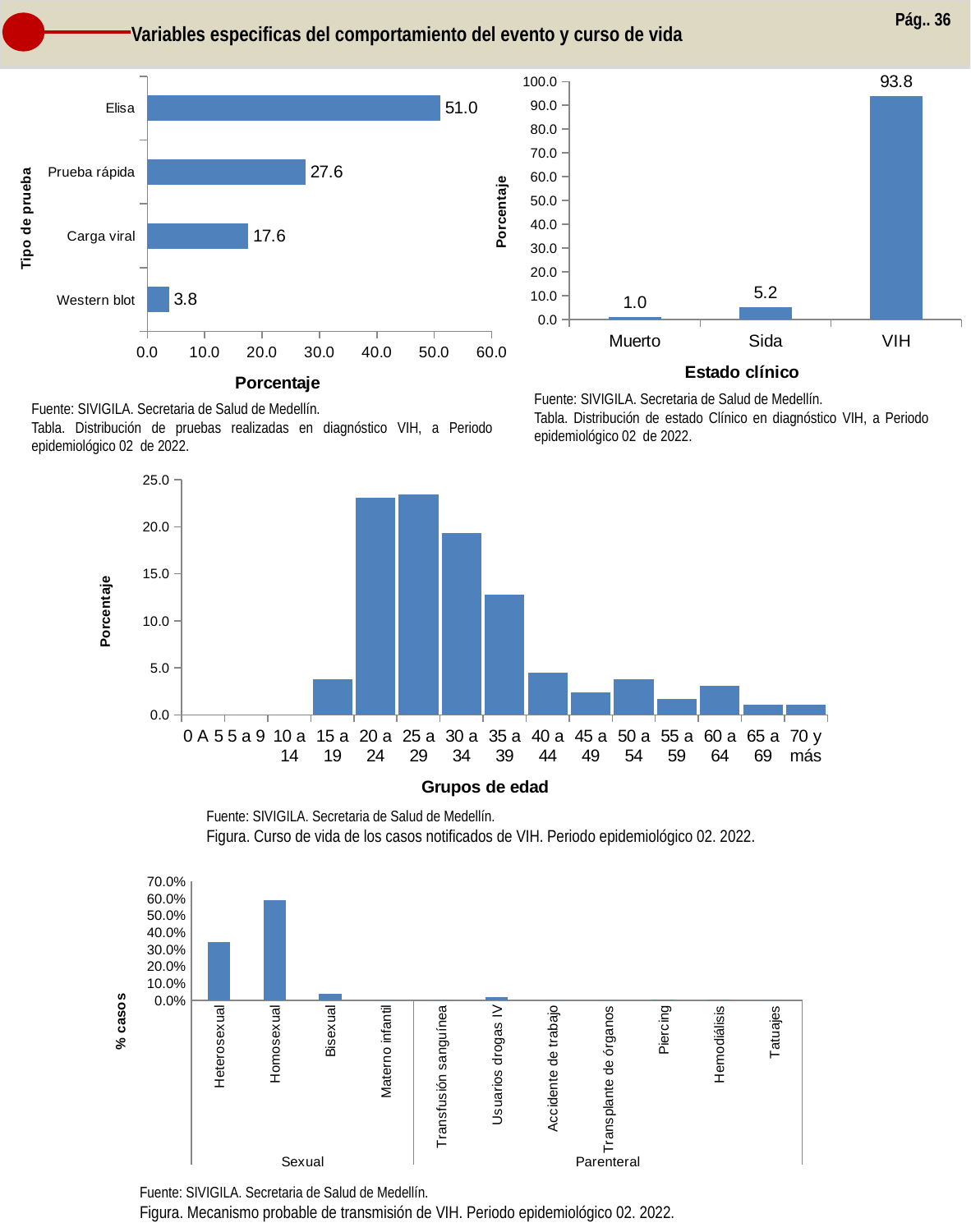
What kind of chart is the top-left chart (Tipo de prueba)? Bar chart In the top-left chart (Tipo de prueba), which test type has the lowest value? Western blot In the bottom chart (% casos), is the value for Homosexual greater or less than 50.0%? greater In the top-right chart (Estado clínico), what is the value for VIH? 93.8 In the middle chart (Grupos de edad), is the value for 15 a 19 greater or less than 5.0? less How many categories are shown in the top-right chart (Estado clínico)? 3 In the top-left chart (Tipo de prueba), what is the difference between the values for Elisa and Prueba rápida? 23.4 How many age groups are shown on the x axis of the middle chart (Grupos de edad)? 15 In the top-left chart (Tipo de prueba), what is the value for Elisa? 51.0 In the bottom chart (% casos), which is larger, the value for Heterosexual or Homosexual? Homosexual In the middle chart (Grupos de edad), is the value for 25 a 29 greater or less than 20.0? greater In the top-right chart (Estado clínico), what is the difference between the values for Sida and Muerto? 4.2